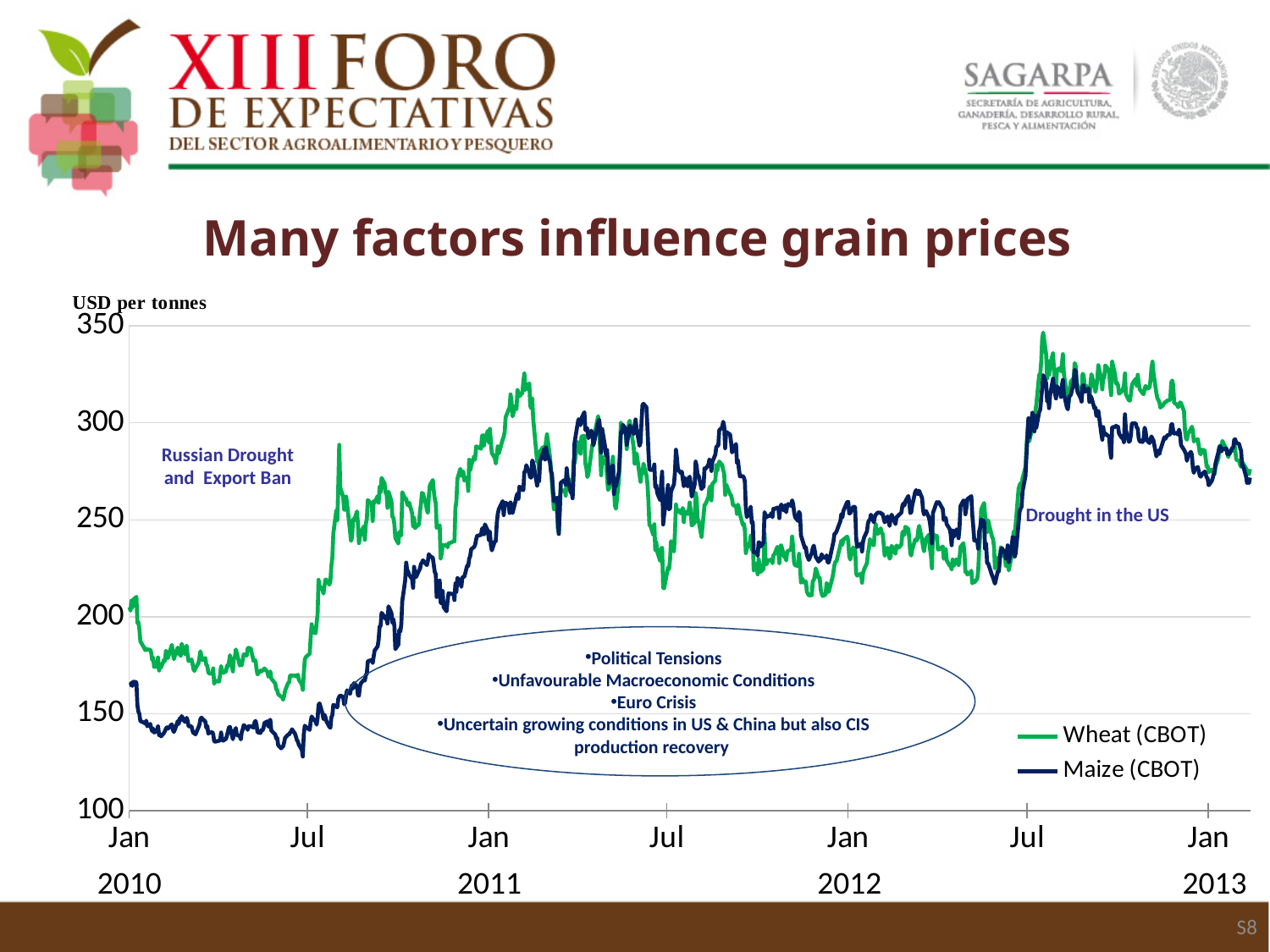
What kind of chart is shown on the slide? line chart What unit is given for the y axis of the chart? USD per tonnes Which two series are listed in the chart legend? Wheat (CBOT) and Maize (CBOT) Is the Wheat (CBOT) price in Jan 2013 greater or less than 250? greater How many series does the legend list? 2 In Jan 2010, which series has the higher price, Wheat (CBOT) or Maize (CBOT)? Wheat (CBOT) Is the Wheat (CBOT) price in Jan 2010 greater or less than 250? less Does the Maize (CBOT) price rise or fall between Jul 2010 and Jan 2011? rise Is the Maize (CBOT) price in Jan 2010 greater or less than 150? greater Does the Wheat (CBOT) price rise or fall between Jul 2010 and Jan 2011? rise